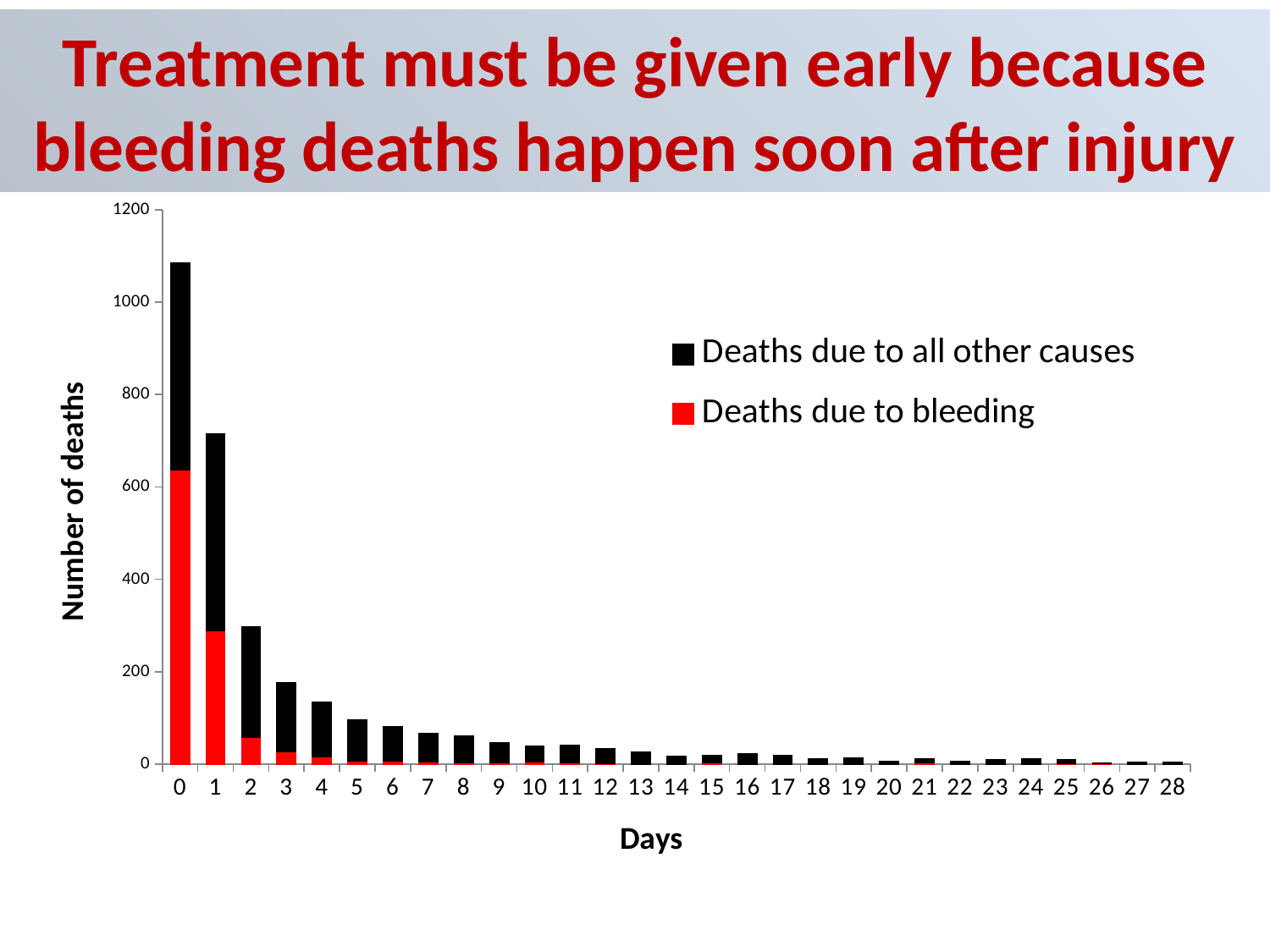
How many days (categories) are shown along the x axis? 29 On day 0, which is larger: deaths due to bleeding or deaths due to all other causes? Deaths due to bleeding Which day has the highest total number of deaths? 0 Is the total number of deaths on day 2 greater or less than 400? less Which colour represents deaths due to bleeding in the chart? Red How many series does the legend list? 2 What is the title of the y axis? Number of deaths What kind of chart is shown on the slide? Stacked bar chart Is the total number of deaths on day 1 greater or less than 600? greater Is the total number of deaths on day 0 greater or less than 1000? greater Do the total deaths rise or fall as the days increase along the x axis? Fall